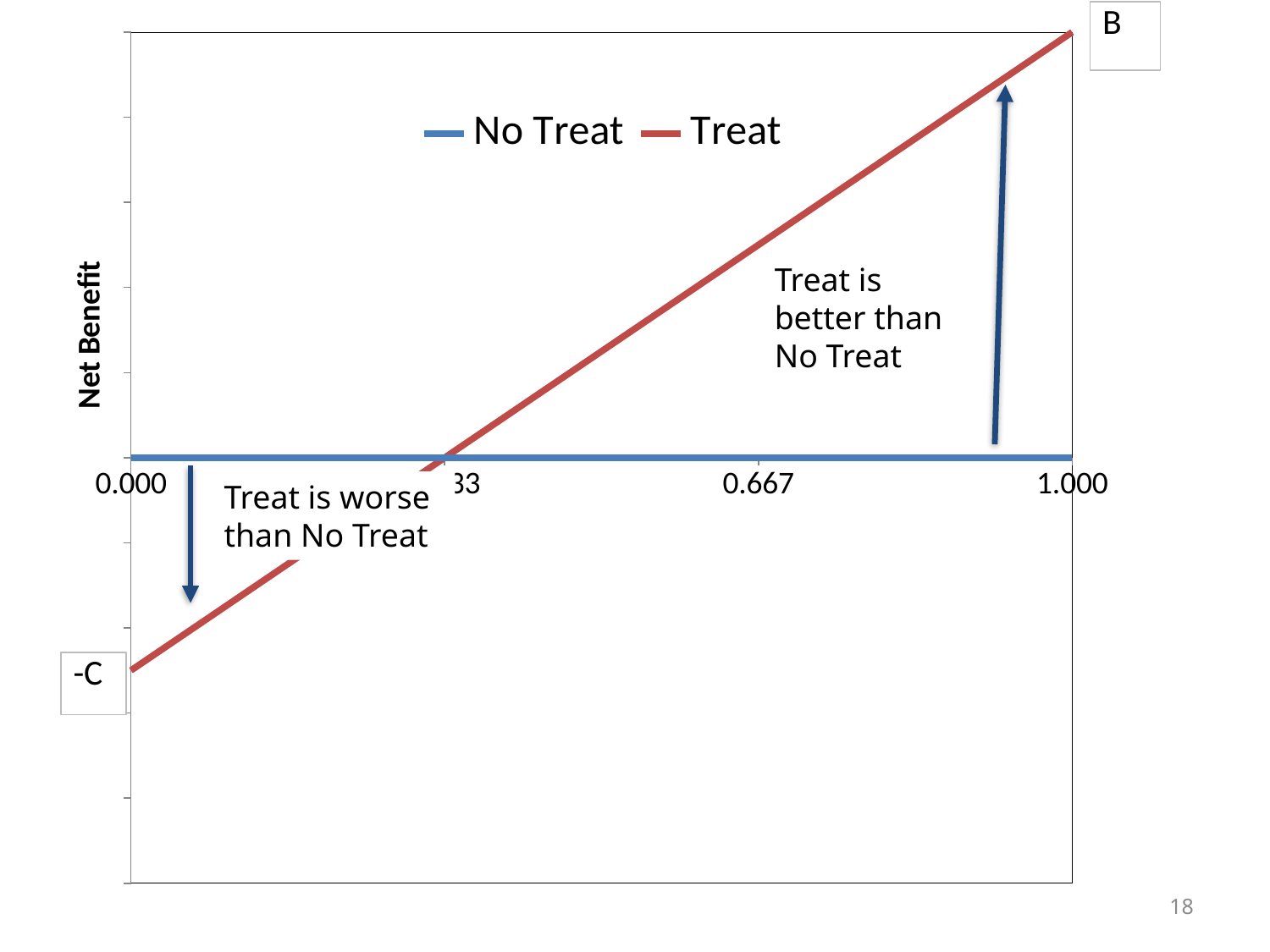
Does the No Treat line rise, fall, or stay flat across the x axis? stay flat What label marks the value of the Treat line at x = 0.000? -C What is the largest value shown on the x axis? 1.000 At x = 0.000, which series has the higher Net Benefit, Treat or No Treat? No Treat At x = 0.667, which series has the higher Net Benefit, Treat or No Treat? Treat Does the Treat line rise or fall as the x-axis value increases from 0.000 to 1.000? rise What are the two series named in the legend? No Treat and Treat How many series does the legend list? 2 What kind of chart is shown on the slide? line chart What label marks the value of the Treat line at x = 1.000? B What is the label on the vertical axis? Net Benefit At x = 1.000, which series has the higher Net Benefit, Treat or No Treat? Treat